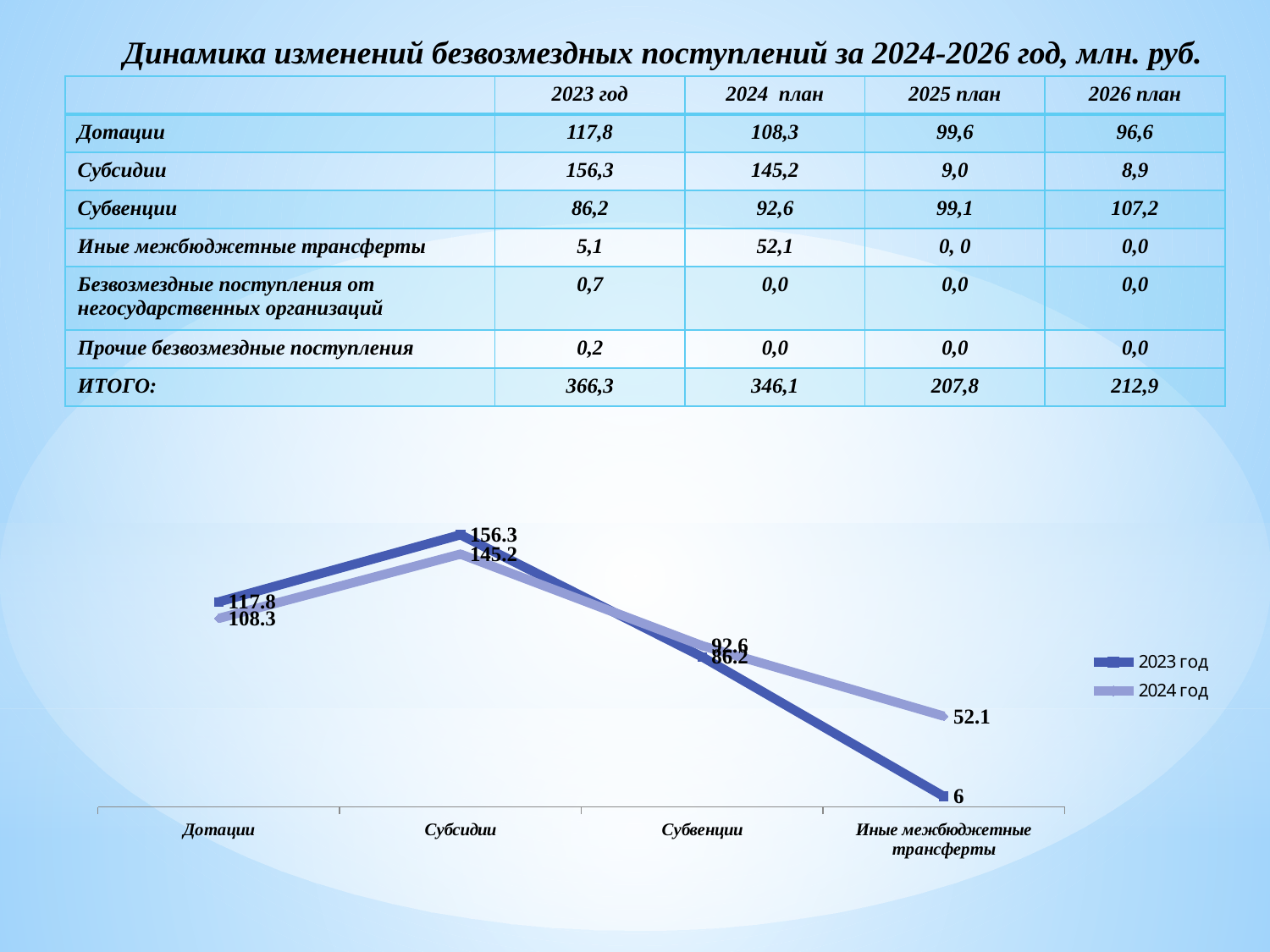
What is the difference between the 2023 год and 2024 год values for Дотации on the chart? 9.5 What are the two legend entries of the chart? 2023 год and 2024 год Which category has the highest value in the 2023 год series on the chart? Субсидии What is the value for Субвенции in the 2023 год series on the chart? 86.2 What is the value for Иные межбюджетные трансферты in the 2024 год series on the chart? 52.1 Which category has the lowest value in the 2024 год series on the chart? Иные межбюджетные трансферты How many series does the chart legend list? 2 For Субвенции, which series has the larger value on the chart, 2023 год or 2024 год? 2024 год What type of chart is shown on the slide? line chart What is the value for Субсидии in the 2023 год series on the chart? 156.3 What is the value for Дотации in the 2024 год series on the chart? 108.3 How many categories are shown on the x axis of the chart? 4